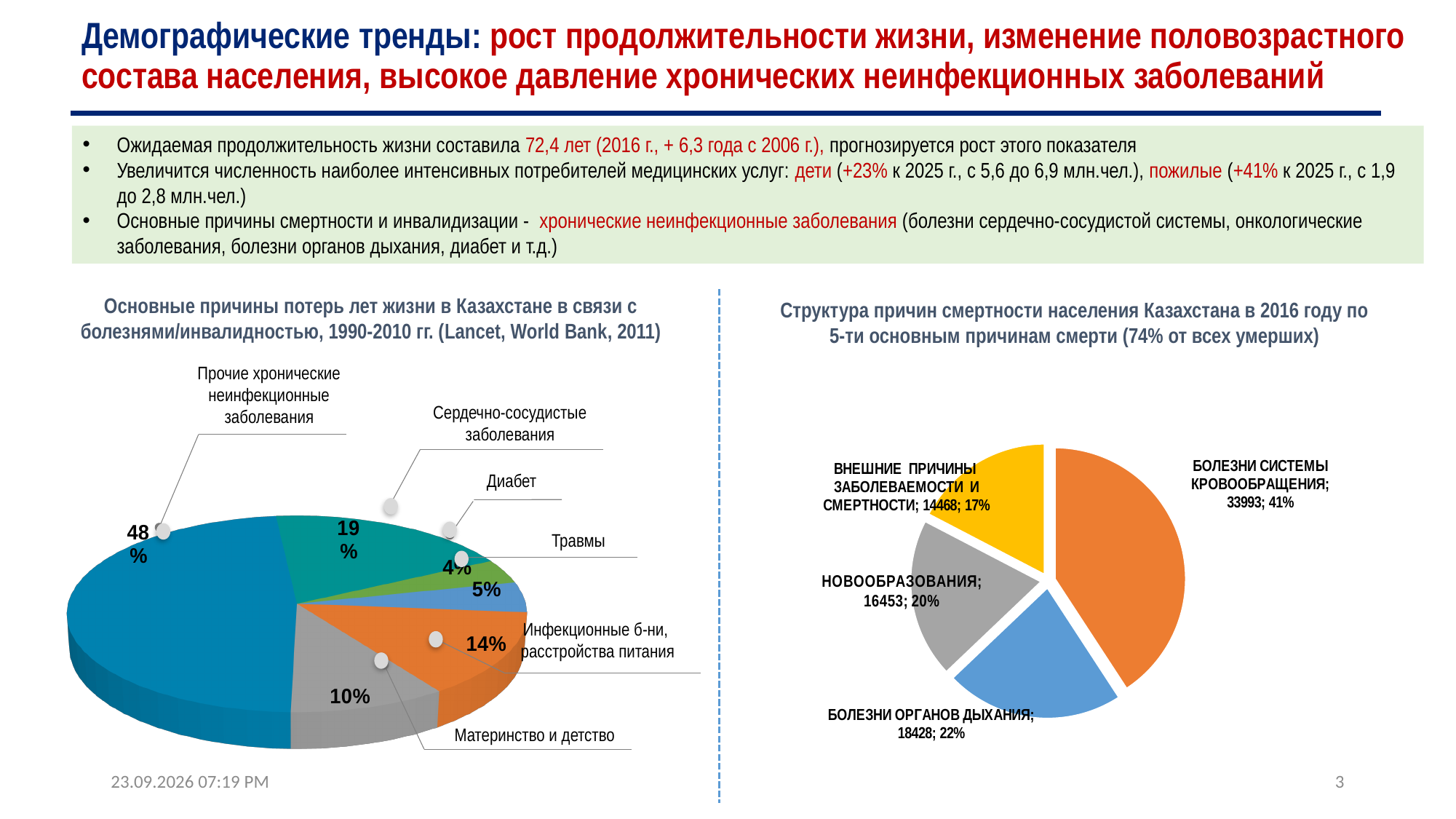
In the left chart (Основные причины потерь лет жизни в Казахстане), what share is shown for Прочие хронические неинфекционные заболевания? 48% In the left chart (Основные причины потерь лет жизни в Казахстане), which category has the smallest share? Диабет In the right chart (Структура причин смертности населения Казахстана в 2016 году), what value is shown for Болезни системы кровообращения? 33993; 41% In the left chart (Основные причины потерь лет жизни в Казахстане), how many categories are shown? 6 In the right chart (Структура причин смертности населения Казахстана в 2016 году), what colour is the slice for Болезни органов дыхания? Blue What kind of chart is the left chart (Основные причины потерь лет жизни в Казахстане)? Pie chart In the left chart (Основные причины потерь лет жизни в Казахстане), which is larger: Инфекционные б-ни, расстройства питания or Травмы? Инфекционные б-ни, расстройства питания In the right chart (Структура причин смертности населения Казахстана в 2016 году), what percentage is shown for Новообразования? 20% In the right chart (Структура причин смертности населения Казахстана в 2016 году), which cause has the largest share? Болезни системы кровообращения In the right chart (Структура причин смертности населения Казахстана в 2016 году), what is the difference in number of deaths between Болезни органов дыхания and Внешние причины заболеваемости и смертности? 3960 In the left chart (Основные причины потерь лет жизни в Казахстане), what share is shown for Материнство и детство? 10% In the left chart (Основные причины потерь лет жизни в Казахстане), what share is shown for Сердечно-сосудистые заболевания? 19%